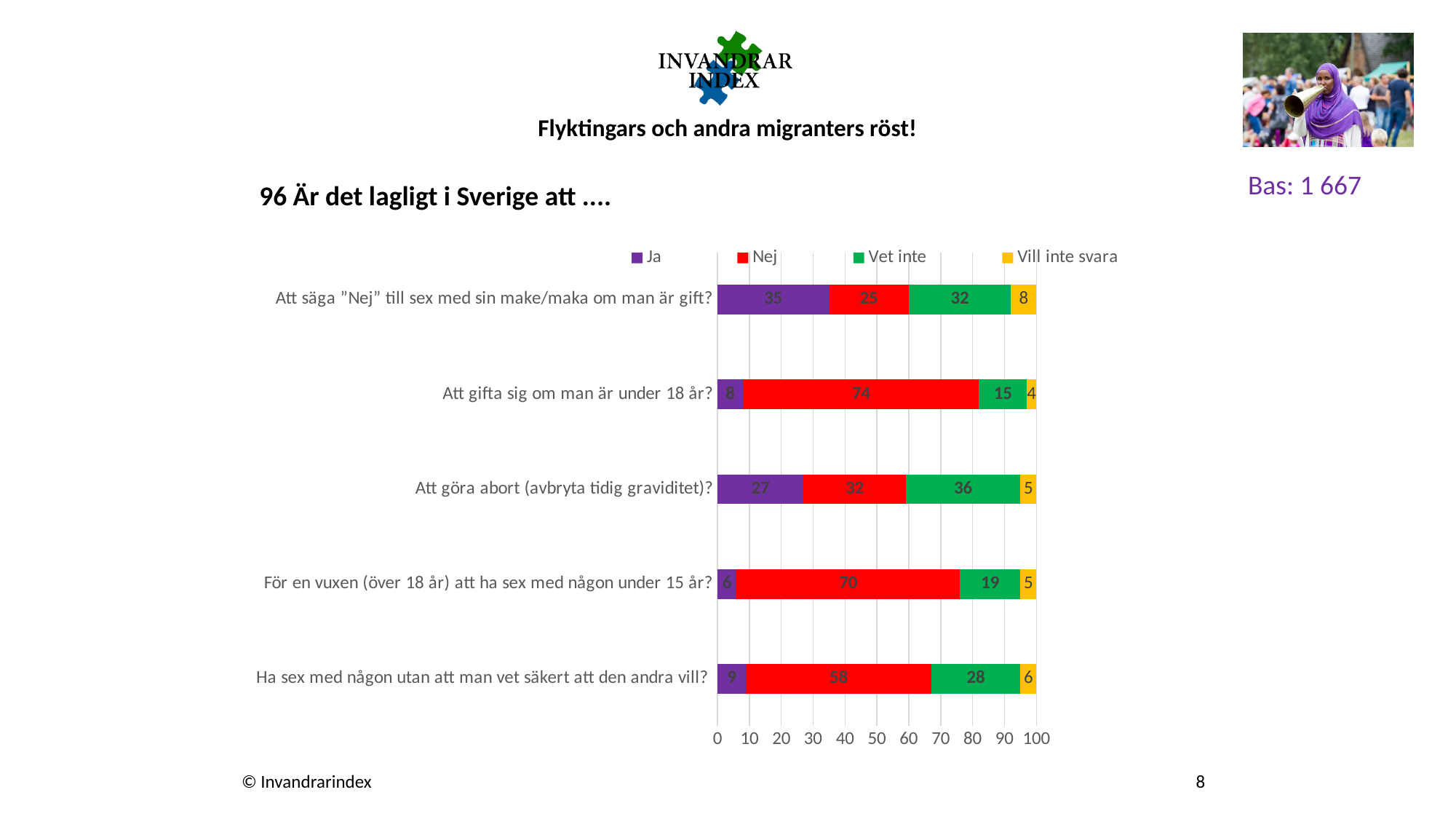
Which category has the lowest "Ja" value? För en vuxen (över 18 år) att ha sex med någon under 15 år? What is the "Ja" value for "Att säga "Nej" till sex med sin make/maka om man är gift?"? 35 How many categories are shown on the chart? 5 How many series does the legend list? 4 What is the "Vet inte" value for "Att göra abort (avbryta tidig graviditet)?"? 36 What is the total of the stacked bar for "Att säga "Nej" till sex med sin make/maka om man är gift?"? 100 What is the "Vill inte svara" value for "Ha sex med någon utan att man vet säkert att den andra vill?"? 6 Which category has the highest "Nej" value? Att gifta sig om man är under 18 år? What is the difference between the "Nej" values for "För en vuxen (över 18 år) att ha sex med någon under 15 år?" and "Ha sex med någon utan att man vet säkert att den andra vill?"? 12 What is the "Nej" value for "Att gifta sig om man är under 18 år?"? 74 Which is larger: the "Ja" value for "Att göra abort (avbryta tidig graviditet)?" or the "Ja" value for "Att gifta sig om man är under 18 år?"? Att göra abort (avbryta tidig graviditet)? What kind of chart is shown on the slide? Stacked bar chart